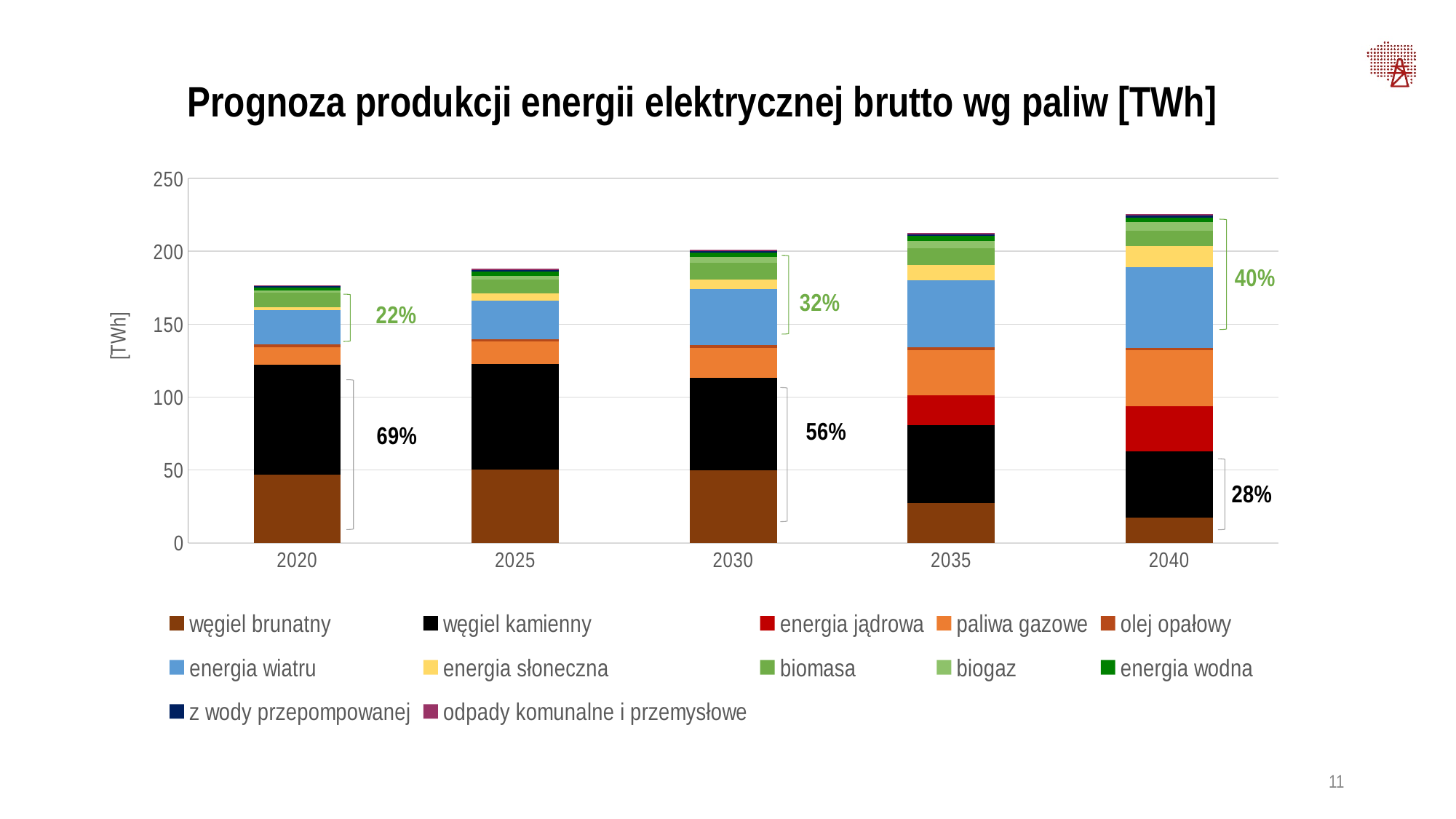
What percentage label is printed in black next to the 2020 bar? 69% Is the total stacked bar for 2020 greater or less than 200? less How many years are shown on the x axis of the chart? 5 How many series does the legend list? 12 Which year has the shortest stacked bar? 2020 Does the total height of the stacked bars rise or fall from 2020 to 2040? rise What kind of chart is shown on the slide? stacked bar chart What percentage label is printed in green next to the 2040 bar? 40% Is the węgiel brunatny segment for 2040 greater or less than 50? less Which year has the tallest stacked bar? 2040 Is the total stacked bar for 2040 greater or less than 200? greater What is the title of the chart? Prognoza produkcji energii elektrycznej brutto wg paliw [TWh]